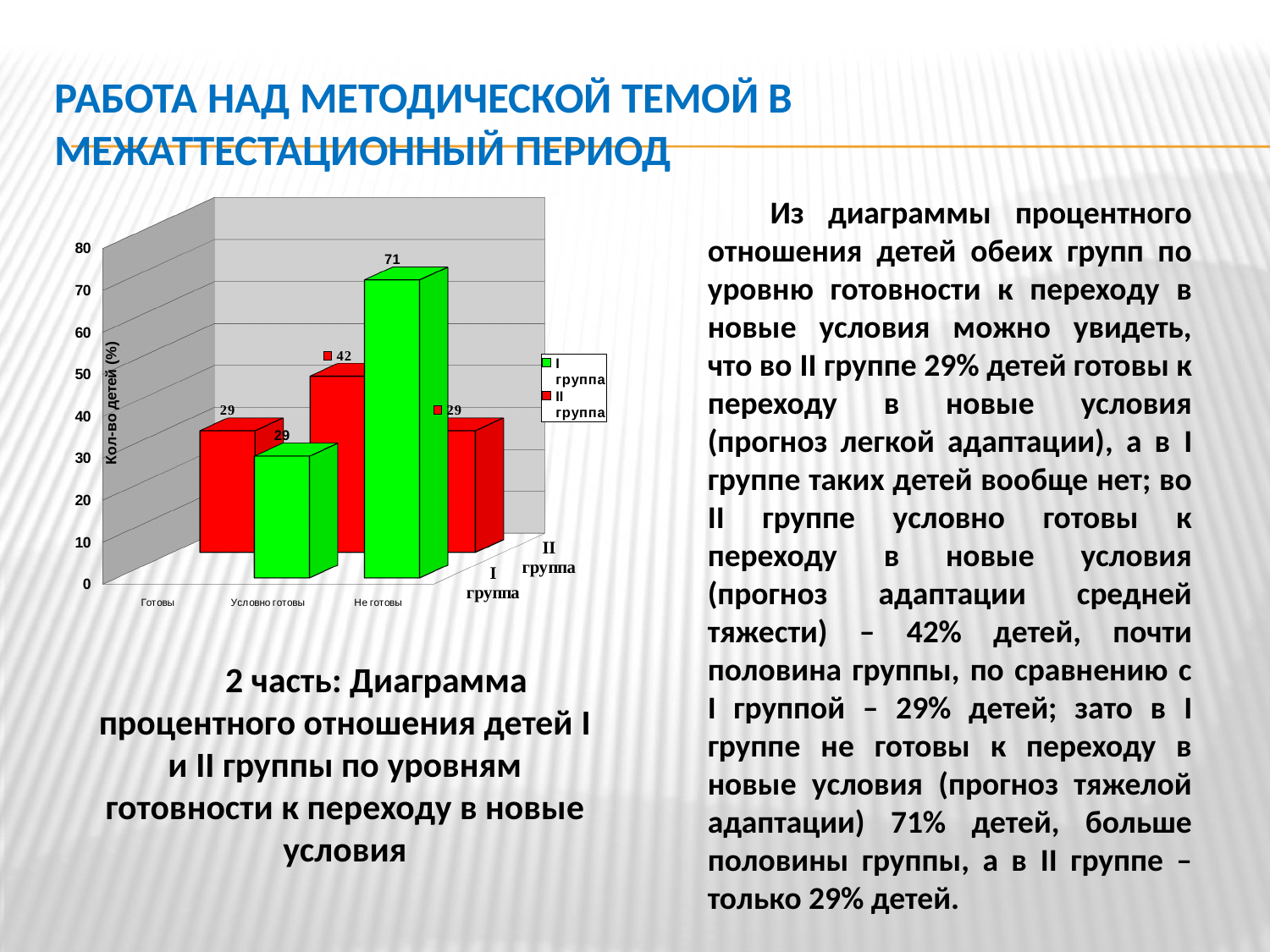
What is the value for I группа in the category Условно готовы? 29 What is the value for I группа in the category Не готовы? 71 How many series does the chart legend list? 2 What is the value for II группа in the category Условно готовы? 42 What is the value for II группа in the category Готовы? 29 In the category Условно готовы, which series has the larger value, I группа or II группа? II группа Which category has the highest value for II группа? Условно готовы What is the difference between the I группа and II группа values in the category Не готовы? 42 Which category has the highest value for I группа? Не готовы What is the value for II группа in the category Не готовы? 29 How many categories are shown on the x axis of the chart? 3 What type of chart is shown on the slide? bar chart